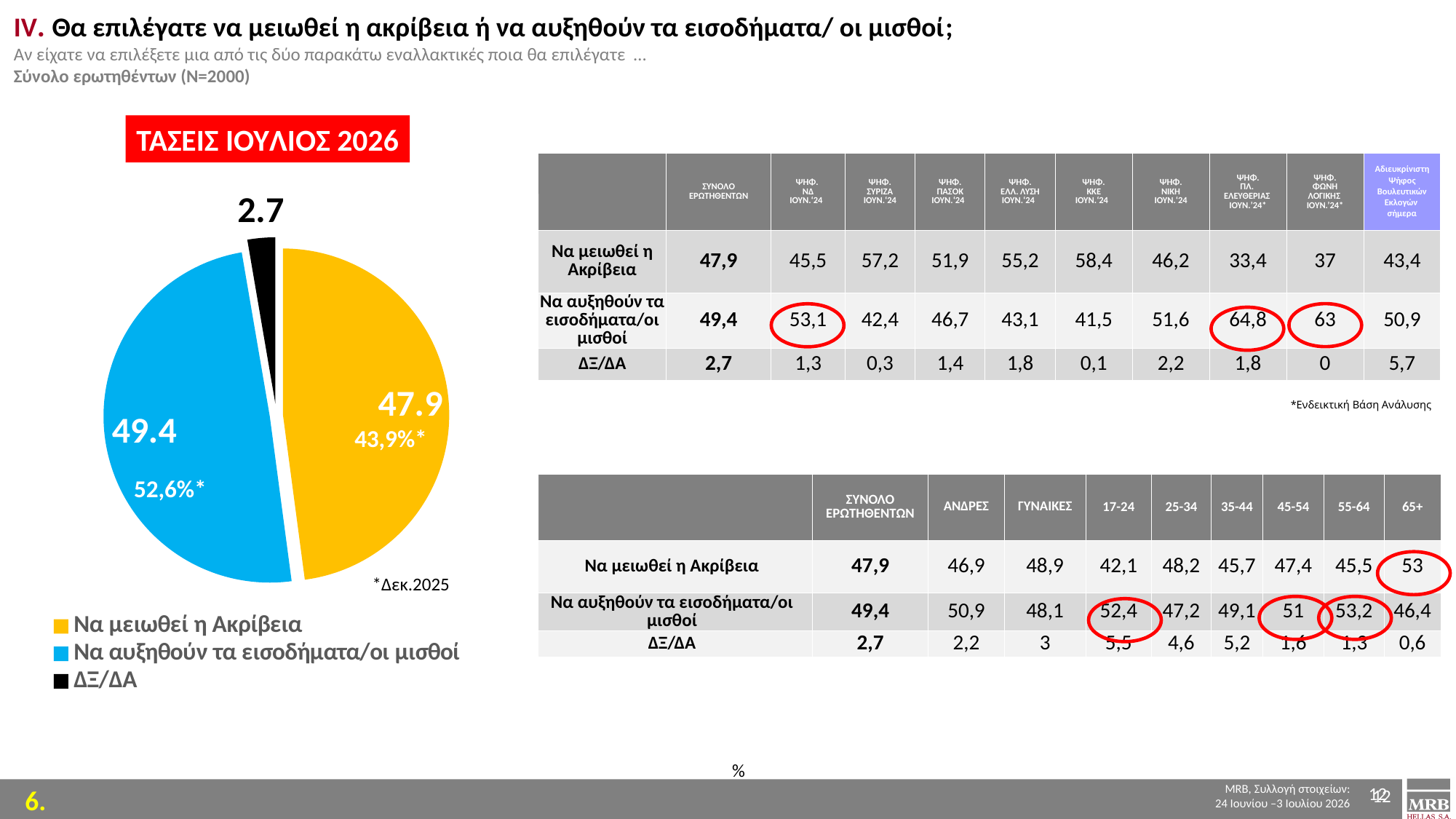
In the pie chart, what is the difference between the value for "Να αυξηθούν τα εισοδήματα/οι μισθοί" and the value for "Να μειωθεί η Ακρίβεια"? 1.5 In the pie chart, what is the value for "Να μειωθεί η Ακρίβεια"? 47.9 How many entries does the pie chart legend list? 3 What is the title shown in the red box above the pie chart? ΤΑΣΕΙΣ ΙΟΥΛΙΟΣ 2026 In the pie chart, what is the difference between the value for "Να μειωθεί η Ακρίβεια" and the value for "ΔΞ/ΔΑ"? 45.2 Which slice of the pie chart is the smallest? ΔΞ/ΔΑ What colour is the "Να μειωθεί η Ακρίβεια" slice in the pie chart? yellow Which slice of the pie chart is the largest? Να αυξηθούν τα εισοδήματα/οι μισθοί In the pie chart, what is the value for "ΔΞ/ΔΑ"? 2.7 In the pie chart, what is the value for "Να αυξηθούν τα εισοδήματα/οι μισθοί"? 49.4 What kind of chart is shown on the left of the slide? pie chart How many slices does the pie chart have? 3